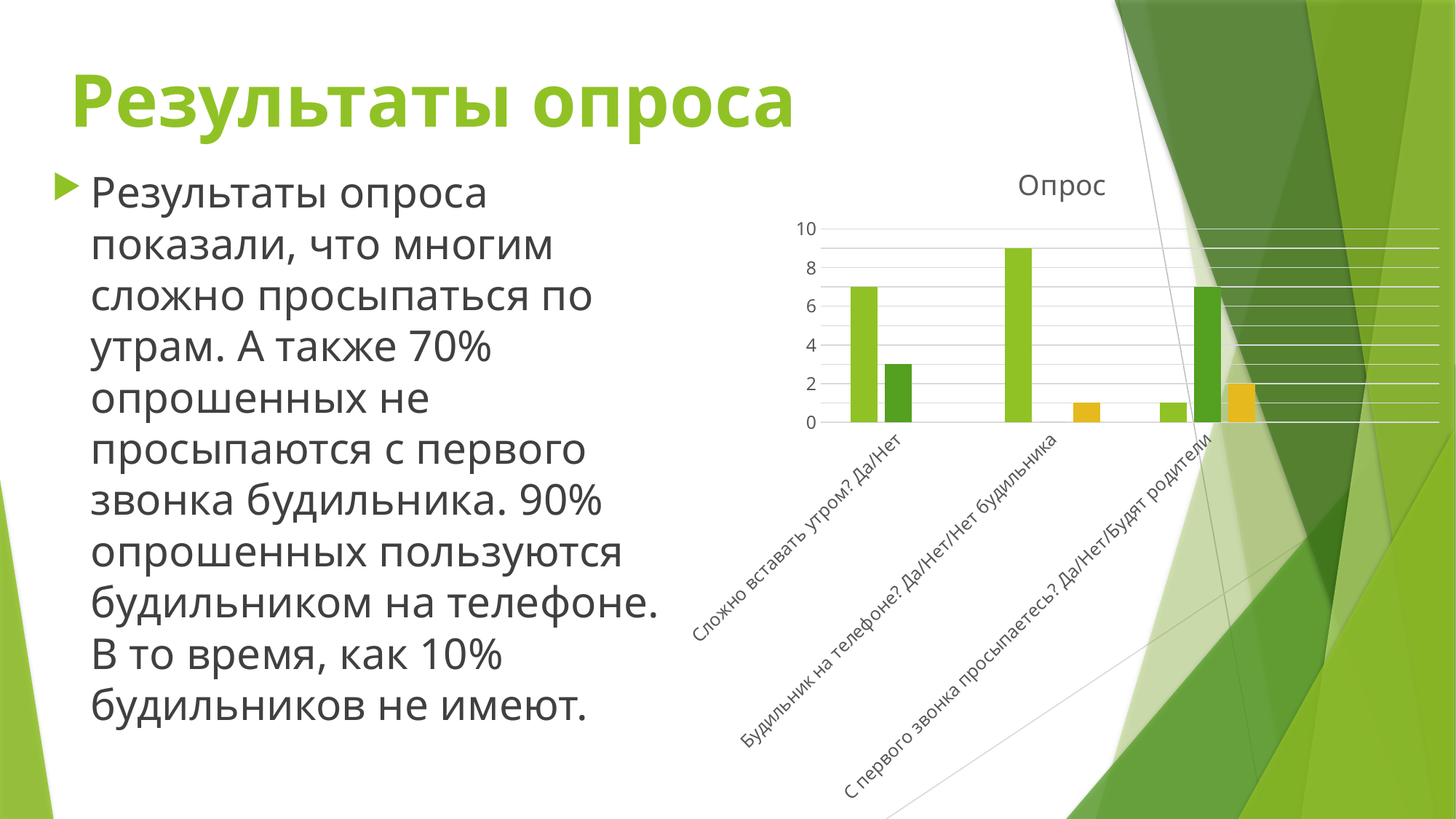
In the category 'Сложно вставать утром? Да/Нет', which bar is taller, the light green one or the dark green one? the light green one Is the value of the dark green bar for 'С первого звонка просыпаетесь? Да/Нет/Будят родители' greater or less than 6? greater Is the value of the light green bar for 'С первого звонка просыпаетесь? Да/Нет/Будят родители' greater or less than 2? less How many categories are shown on the x axis of the chart? 3 What is the title of the chart? Опрос Which category contains the tallest bar in the chart? Будильник на телефоне? Да/Нет/Нет будильника What is the highest value shown on the vertical axis of the chart? 10 Is the value of the light green bar for 'Будильник на телефоне? Да/Нет/Нет будильника' greater or less than 8? greater How many bars are shown for the category 'С первого звонка просыпаетесь? Да/Нет/Будят родители'? 3 What kind of chart is shown on the slide? bar chart